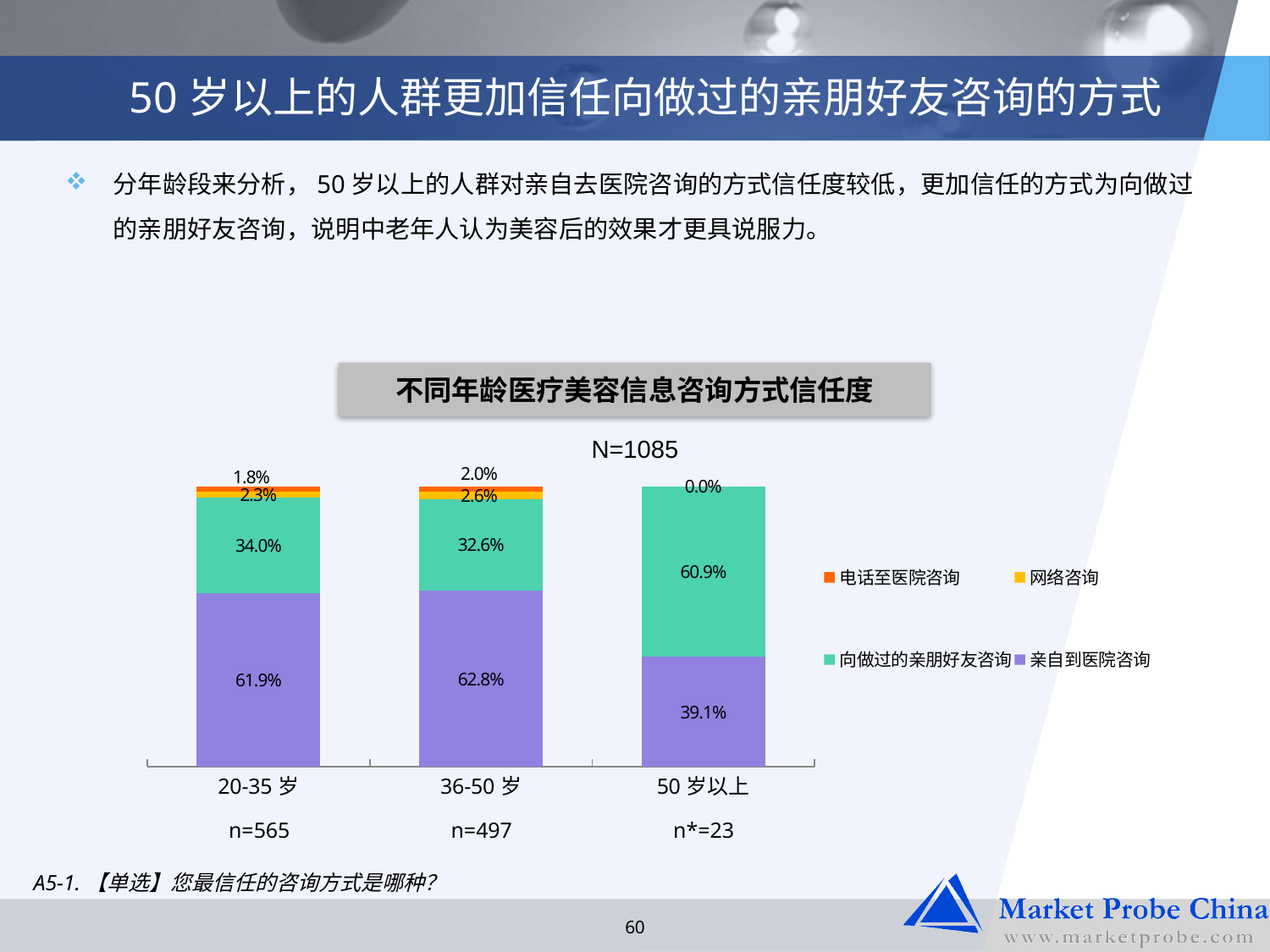
What is the difference between the 亲自到医院咨询 values for the 36-50 岁 and 20-35 岁 groups? 0.9 percentage points What is the value for 向做过的亲朋好友咨询 in the 50 岁以上 group? 60.9% How many age groups are shown on the x axis? 3 What is the value for 亲自到医院咨询 in the 20-35 岁 group? 61.9% What is the value for 电话至医院咨询 in the 20-35 岁 group? 1.8% What kind of chart is shown on the slide? Stacked bar chart Which age group has the lowest value for 亲自到医院咨询? 50 岁以上 What is the value for 亲自到医院咨询 in the 36-50 岁 group? 62.8% What is the value for 网络咨询 in the 36-50 岁 group? 2.6% How many series does the legend list? 4 Which age group has the highest value for 向做过的亲朋好友咨询? 50 岁以上 In the 50 岁以上 group, which is larger: 亲自到医院咨询 or 向做过的亲朋好友咨询? 向做过的亲朋好友咨询